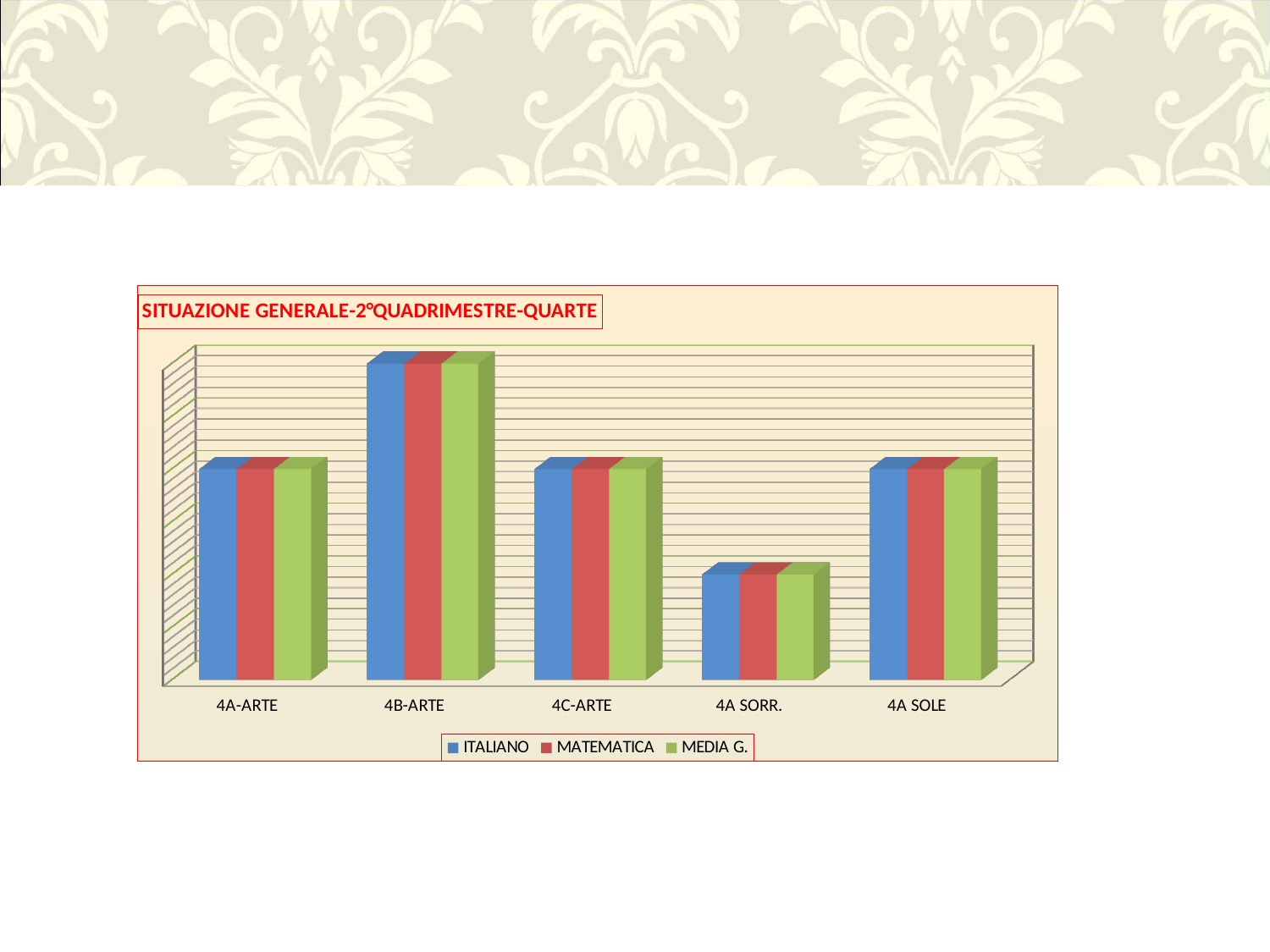
What kind of chart is shown on the slide? bar chart Which has the smaller MEDIA G. value, 4A SOLE or 4A SORR.? 4A SORR. Which category has the lowest bars in the chart? 4A SORR. Which category has the highest bars in the chart? 4B-ARTE Which has the larger MATEMATICA value, 4B-ARTE or 4C-ARTE? 4B-ARTE How many categories are shown on the x axis of the chart? 5 What is the title of the chart? SITUAZIONE GENERALE-2°QUADRIMESTRE-QUARTE Is the ITALIANO value for 4B-ARTE larger or smaller than the ITALIANO value for 4A SORR.? larger Which series is shown in red in the chart's legend? MATEMATICA How many series does the chart's legend list? 3